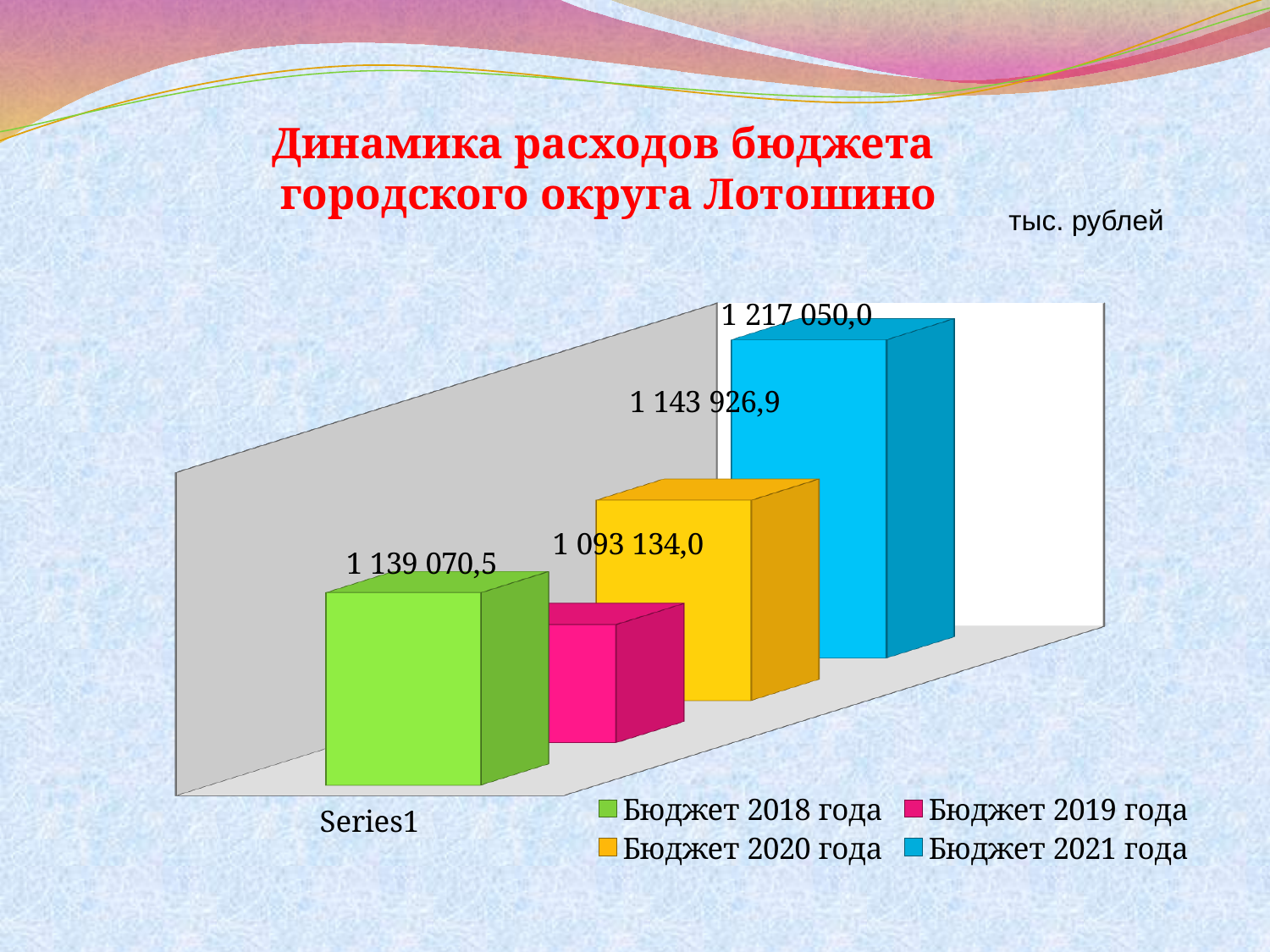
Which budget year has the lowest value? Бюджет 2019 года What kind of chart is shown on the slide? Bar chart What is the value for Бюджет 2018 года? 1 139 070,5 What is the difference between the values for Бюджет 2020 года and Бюджет 2019 года? 50 792,9 What is the value for Бюджет 2021 года? 1 217 050,0 Which budget year has the highest value? Бюджет 2021 года How many series does the legend list? 4 Which is larger, the value for Бюджет 2018 года or Бюджет 2020 года? Бюджет 2020 года What is the difference between the values for Бюджет 2021 года and Бюджет 2018 года? 77 979,5 What is the value for Бюджет 2020 года? 1 143 926,9 What unit is stated for the values in the chart? тыс. рублей What is the value for Бюджет 2019 года? 1 093 134,0